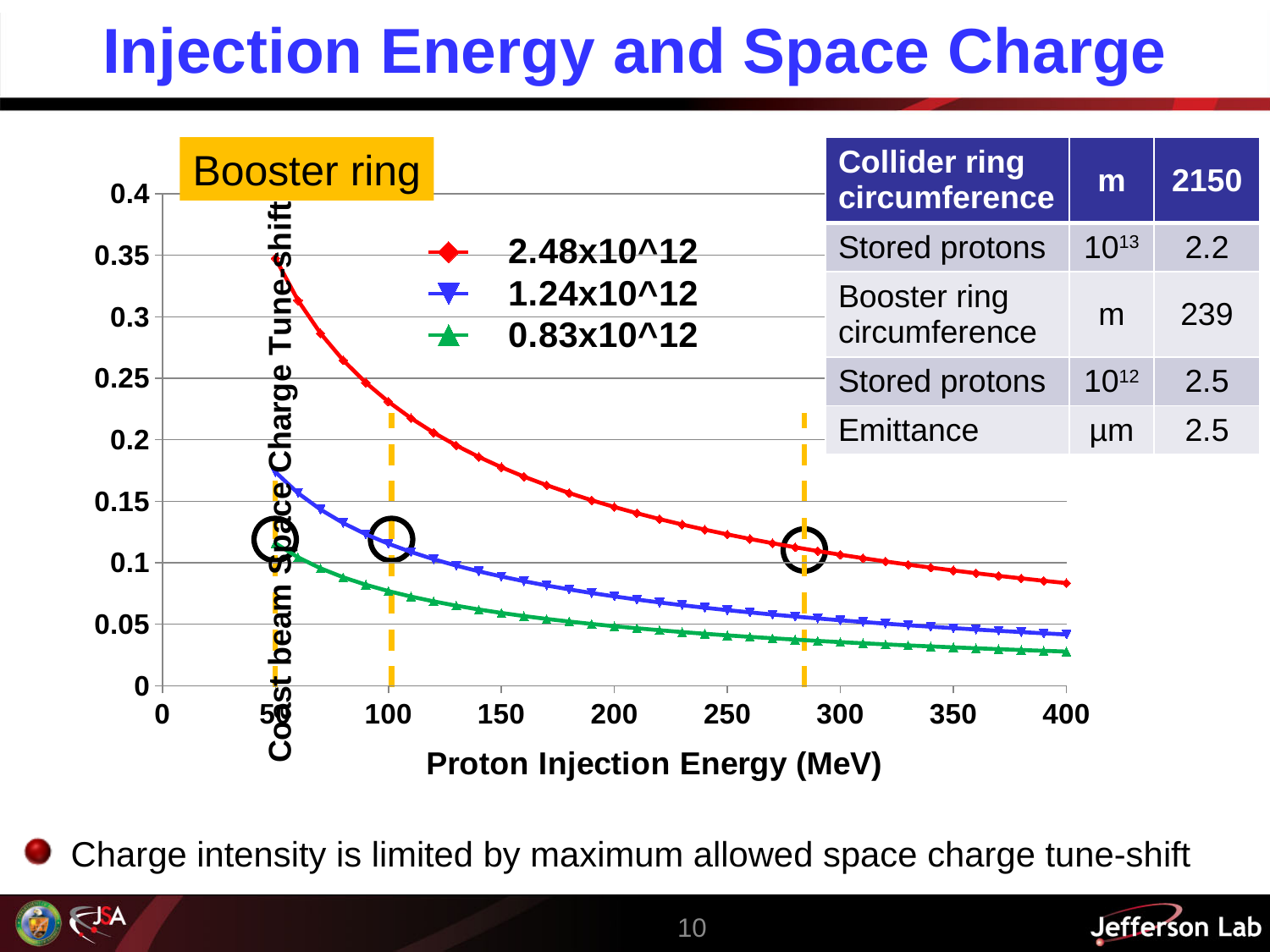
Do the plotted values rise or fall as Proton Injection Energy increases? fall Which legend entry is plotted in red? 2.48x10^12 What kind of chart is shown on the slide? line chart Which series has the highest tune-shift values across the chart? 2.48x10^12 Which series has the lowest tune-shift values across the chart? 0.83x10^12 At 200 MeV, which series has the larger value: 2.48x10^12 or 0.83x10^12? 2.48x10^12 Is the value of the 2.48x10^12 series at 100 MeV greater or less than 0.15? greater Is the value of the 1.24x10^12 series at 200 MeV greater or less than 0.1? less What is the title of the x axis of the chart? Proton Injection Energy (MeV) How many series does the chart legend list? 3 Is the value of the 0.83x10^12 series at 100 MeV greater or less than 0.1? less